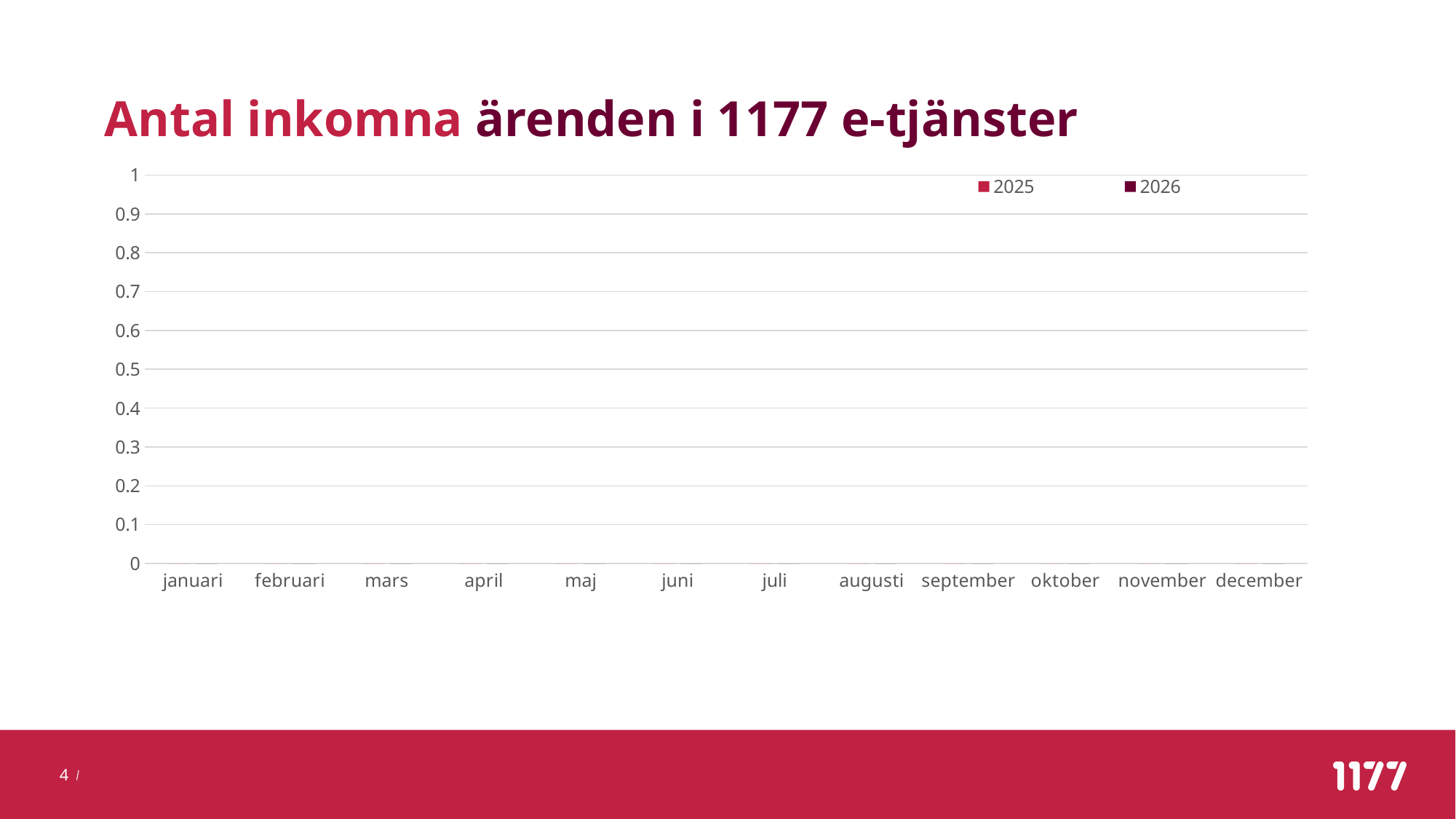
How many categories are shown on the x axis of the chart? 12 What is the last category on the x axis of the chart? december How many series does the chart's legend list? 2 What is the first category on the x axis of the chart? januari What is the lowest value shown on the y axis of the chart? 0 What is the title of the slide containing the chart? Antal inkomna ärenden i 1177 e-tjänster What are the two series named in the chart's legend? 2025 and 2026 What is the highest value shown on the y axis of the chart? 1